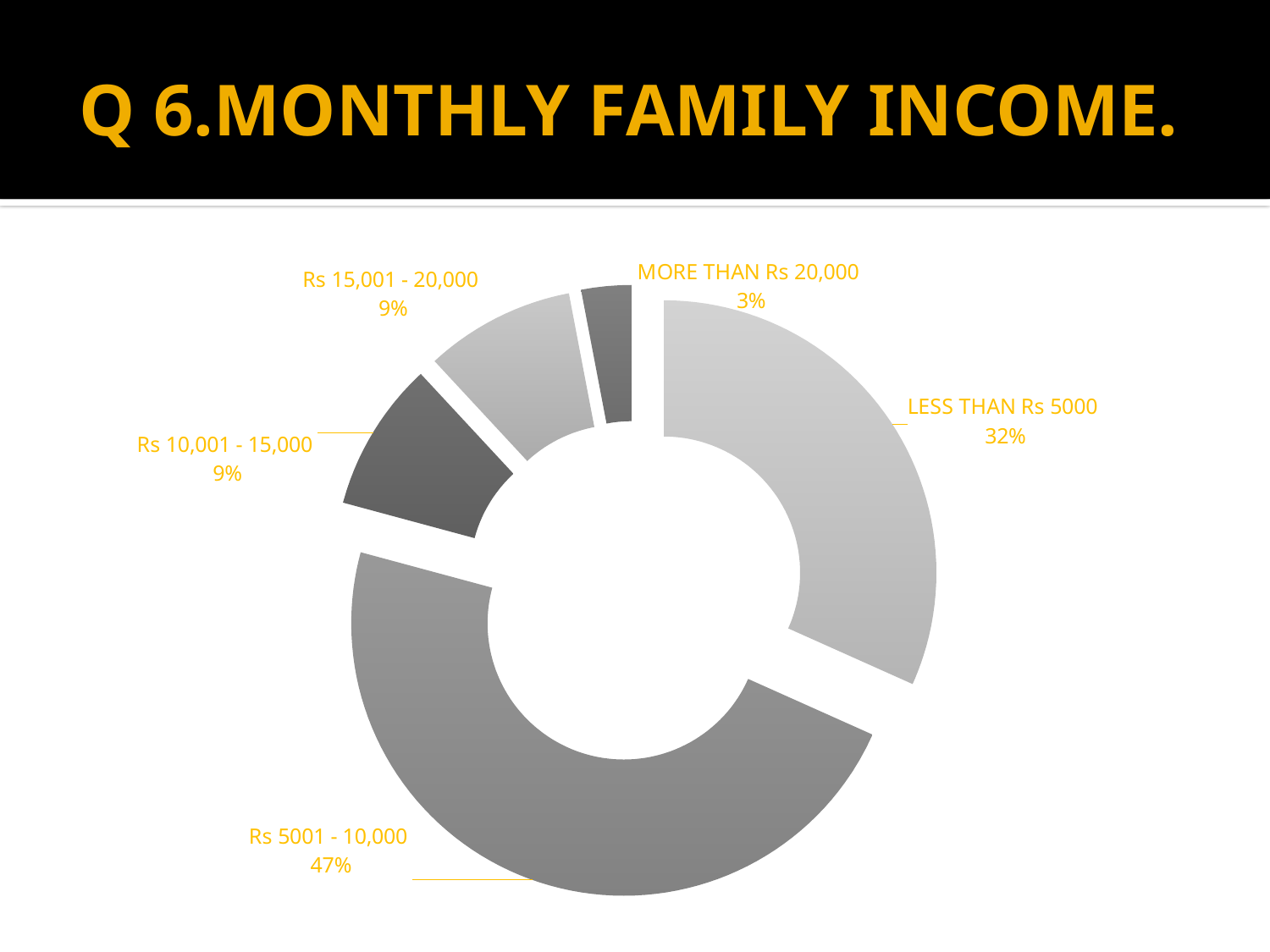
Which income category has the smallest share? MORE THAN Rs 20,000 What is the value shown for MORE THAN Rs 20,000? 3% What is the title of the slide? Q 6.MONTHLY FAMILY INCOME. What share of the chart does the LESS THAN Rs 5000 slice represent? 32% Which income category has the largest share? Rs 5001 - 10,000 What kind of chart is shown on the slide? Doughnut (pie) chart What share of the chart does the Rs 5001 - 10,000 slice represent? 47% How many income categories are shown in the chart? 5 What is the value shown for Rs 10,001 - 15,000? 9% Which is larger, the share for LESS THAN Rs 5000 or the share for Rs 15,001 - 20,000? LESS THAN Rs 5000 What is the value shown for Rs 15,001 - 20,000? 9% What is the difference between the shares for Rs 5001 - 10,000 and LESS THAN Rs 5000? 15%